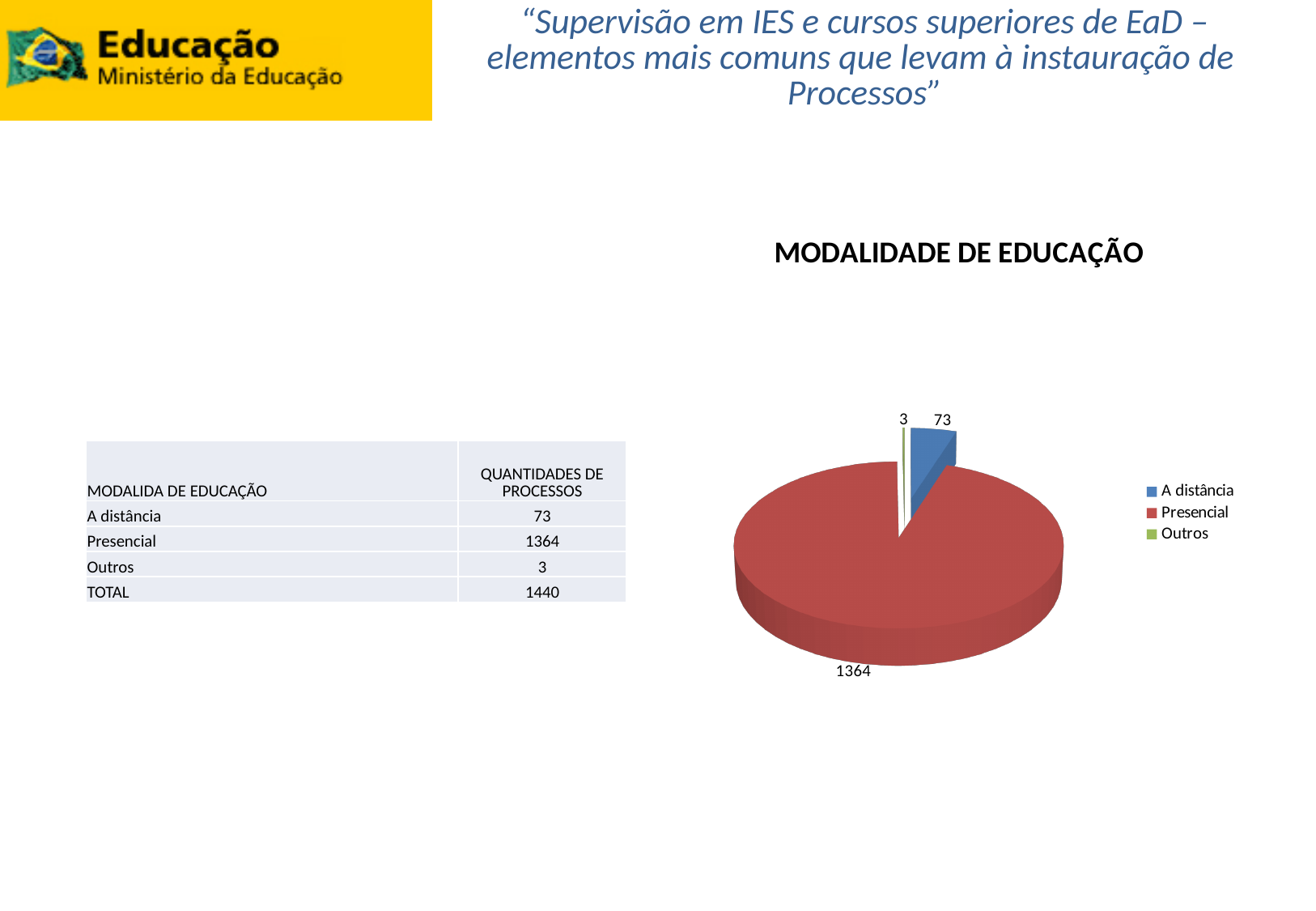
How many categories does the legend of the pie chart list? 3 What colour is the Presencial slice in the pie chart? red What is the title of the chart? MODALIDADE DE EDUCAÇÃO Which category has the smallest slice in the pie chart? Outros Which category has the largest slice in the pie chart? Presencial What is the difference between the values for Presencial and A distância? 1291 What type of chart is shown on the slide? pie chart What is the value for Presencial in the pie chart? 1364 What is the value for A distância in the pie chart? 73 Which is larger, the value for A distância or the value for Outros? A distância What is the total of all slices in the pie chart? 1440 What is the value for Outros in the pie chart? 3